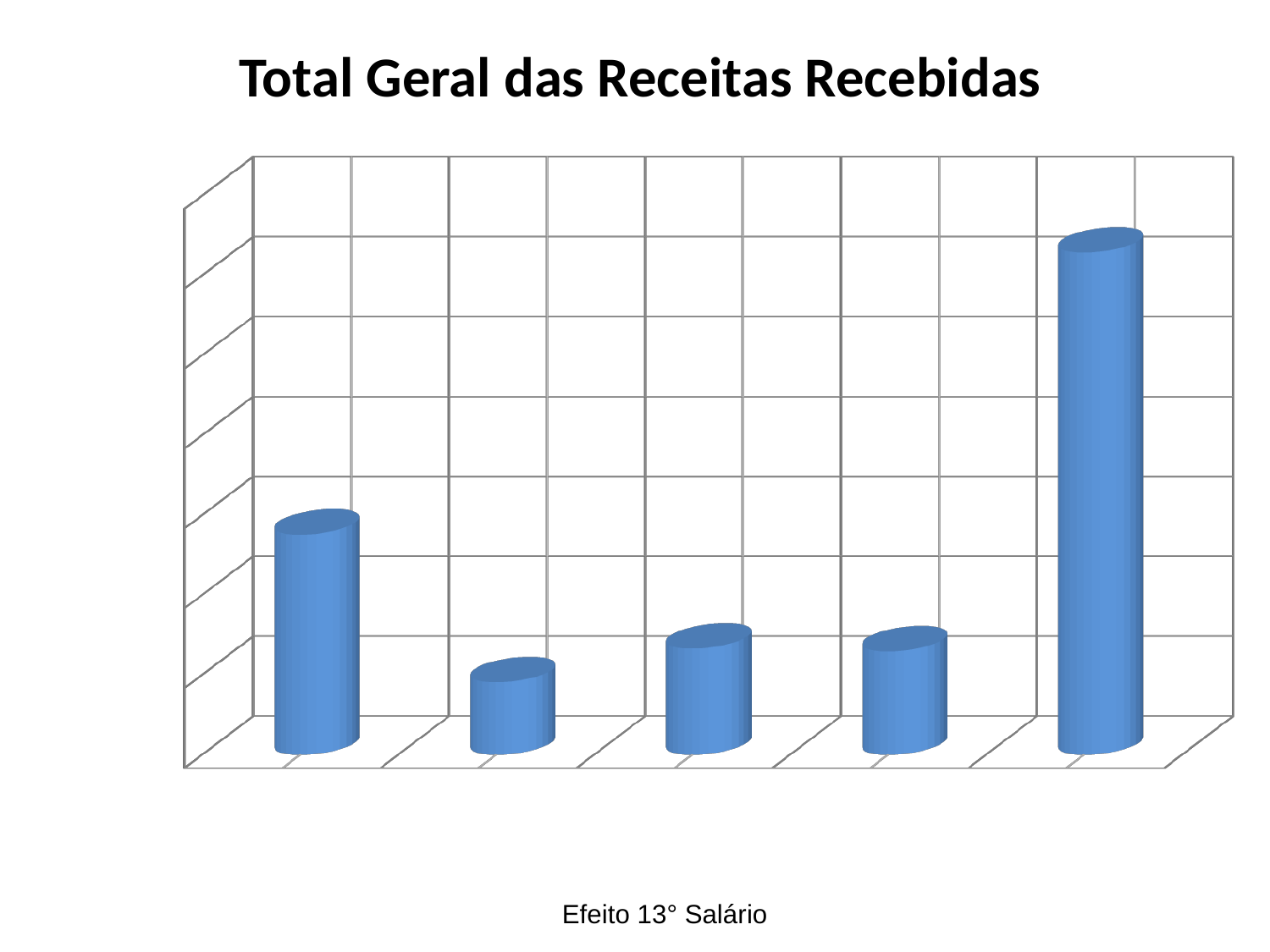
Which is taller, the second bar or the fourth bar? The fourth bar Which bar is the shortest in the chart? The second bar What is the title of the chart? Total Geral das Receitas Recebidas Which is taller, the first bar or the fifth bar? The fifth bar Which is taller, the first bar or the third bar? The first bar Which bar is the tallest in the chart? The fifth (rightmost) bar How many bars are plotted in the chart? 5 What kind of chart is shown on the slide? Bar chart What text appears below the chart? Efeito 13° Salário